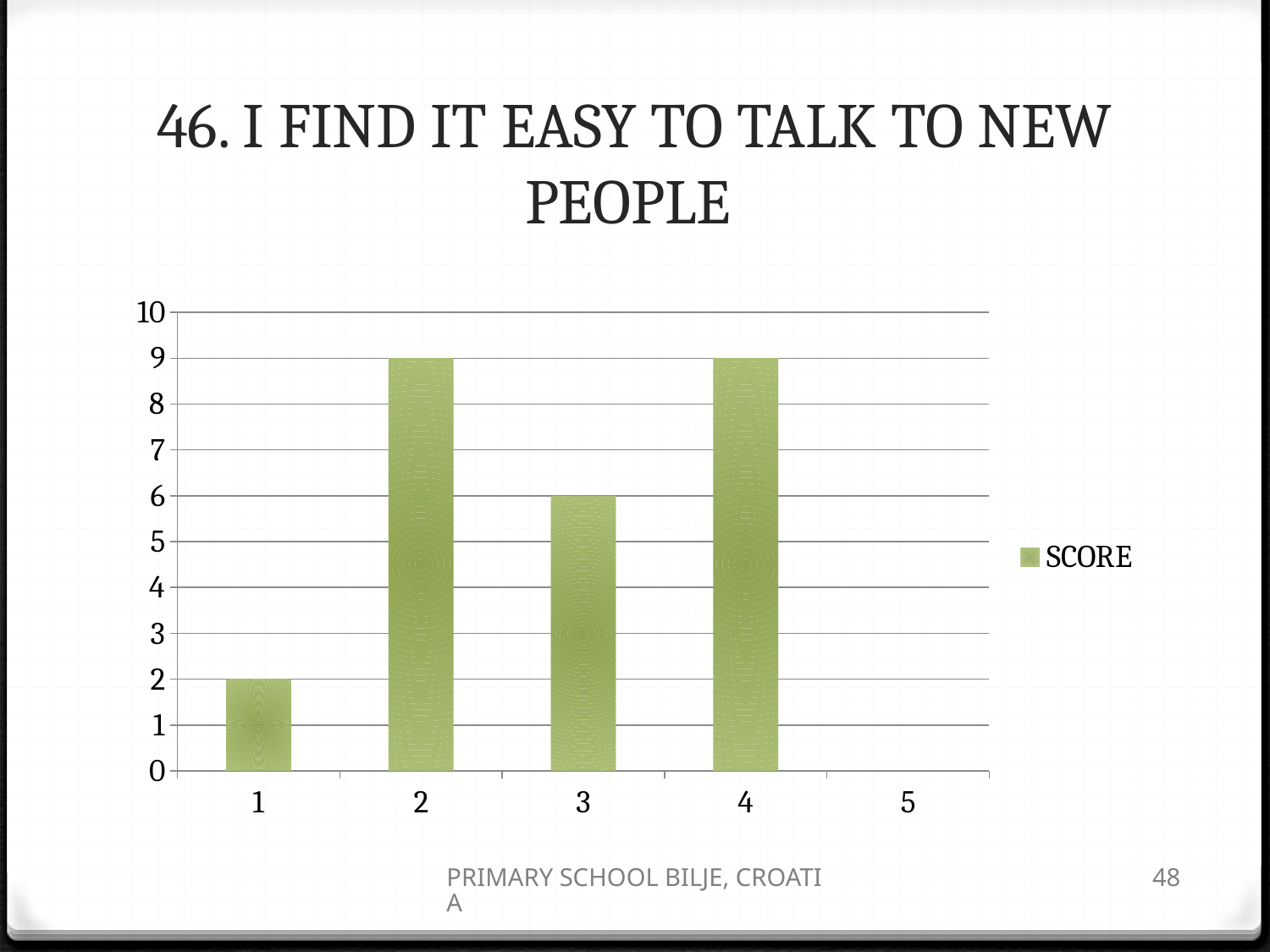
Which is larger, the value for category 2 or the value for category 3? category 2 What is the value for category 1? 2 What is the value for category 4? 9 What is the value for category 2? 9 How many series does the legend list? 1 What is the value for category 3? 6 Is the value for category 1 greater or less than 5? less What is the difference between the values for category 2 and category 3? 3 How many categories are shown on the x axis? 5 What is the difference between the values for category 4 and category 1? 7 What kind of chart is shown on the slide? bar chart